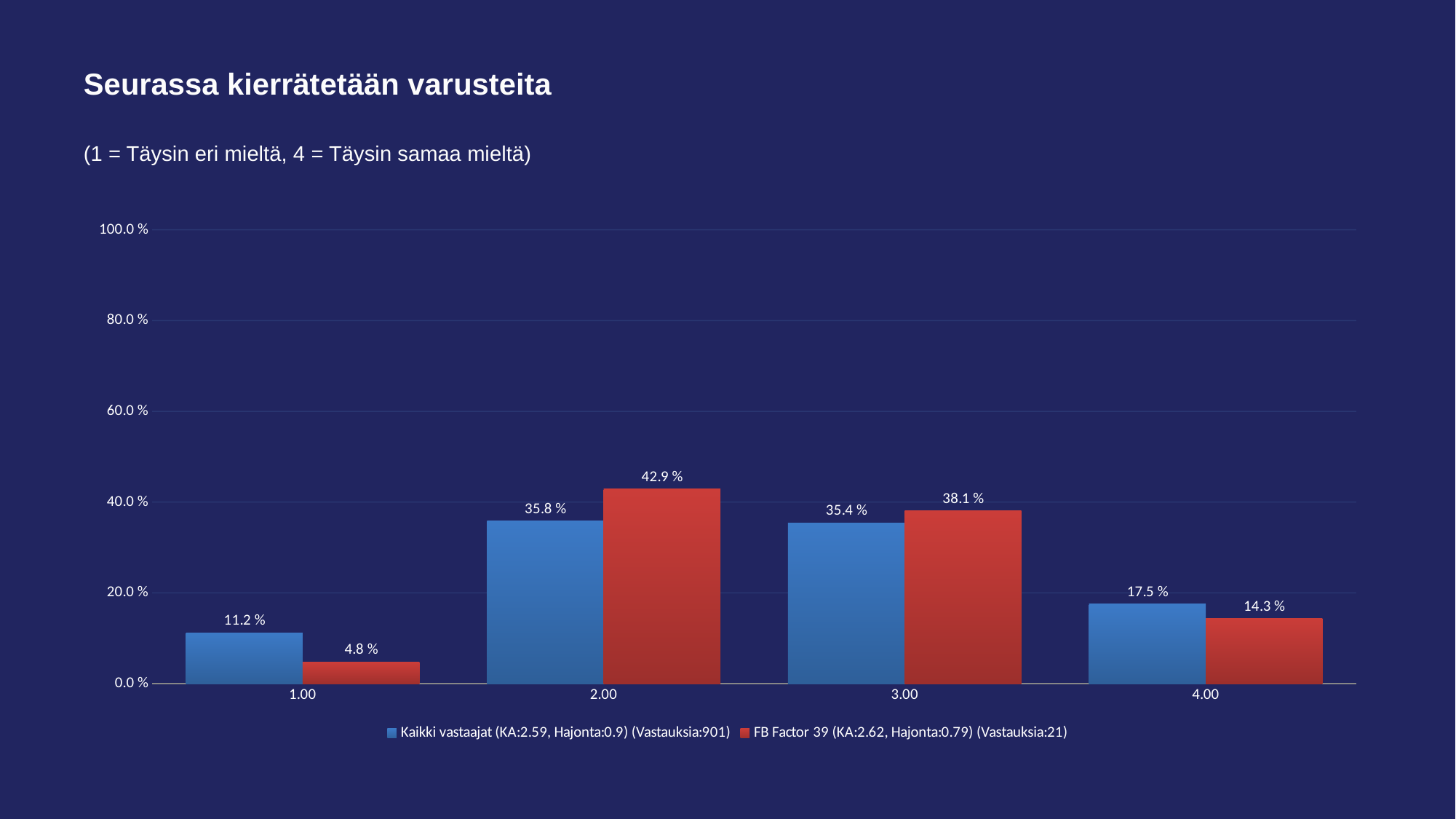
What is the value for FB Factor 39 at category 4.00? 14.3 % At category 4.00, which series has the larger value, Kaikki vastaajat or FB Factor 39? Kaikki vastaajat Which category has the highest value for FB Factor 39? 2.00 How many categories are shown on the x axis? 4 What is the difference between the FB Factor 39 and Kaikki vastaajat values at category 2.00? 7.1 % What is the value for Kaikki vastaajat at category 2.00? 35.8 % What kind of chart is shown on the slide? bar chart How many series does the legend list? 2 Is the value for FB Factor 39 at category 3.00 greater or less than 20.0 %? greater What is the title of the chart? Seurassa kierrätetään varusteita Which category has the lowest value for Kaikki vastaajat? 1.00 What is the value for FB Factor 39 at category 1.00? 4.8 %